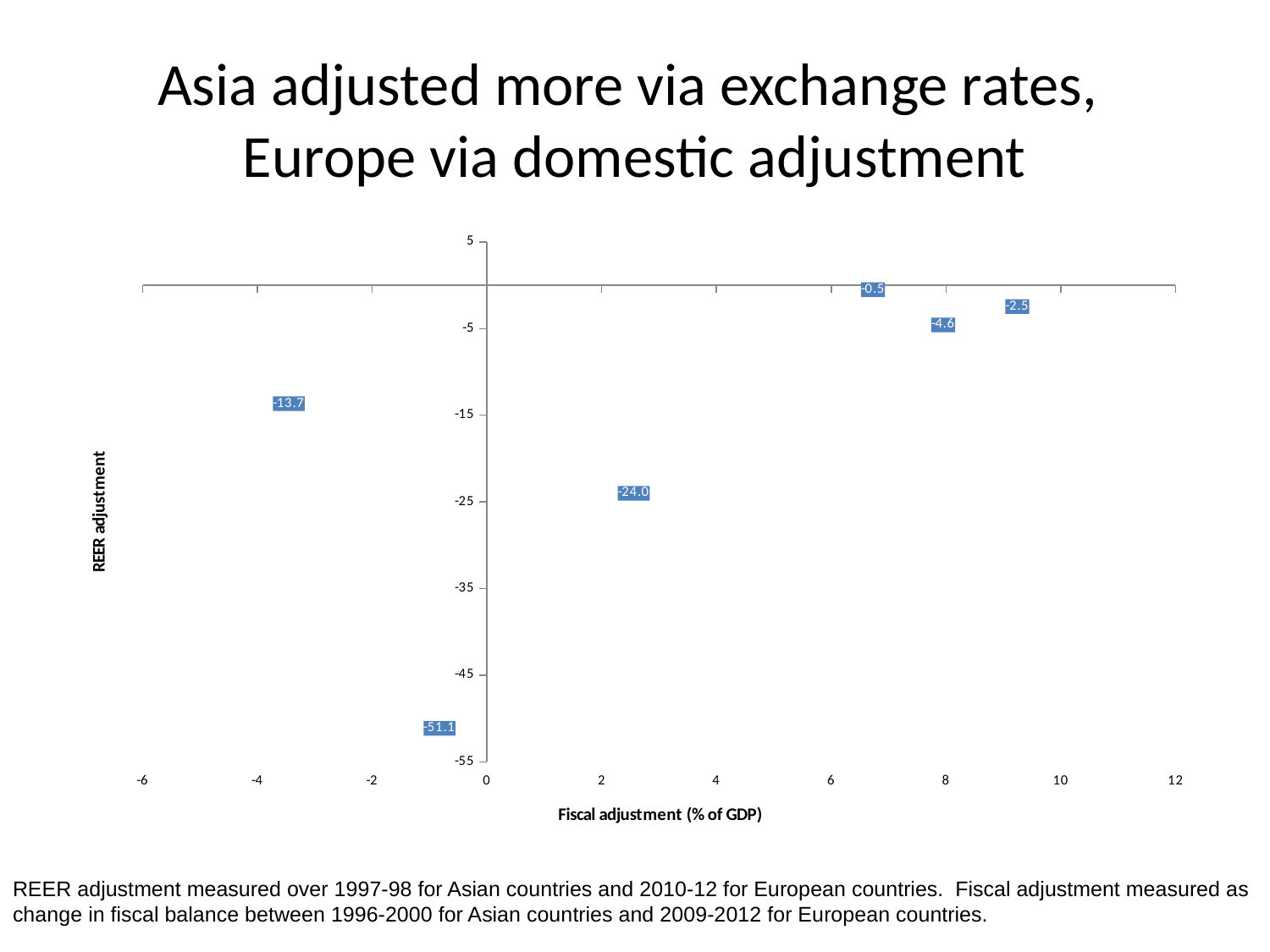
Is the fiscal adjustment for the point labelled -51.1 greater or less than 0? less Is the fiscal adjustment for the point labelled -4.6 greater or less than 6? greater What is the difference between the points labelled -13.7 and -24.0? 10.3 How many data points are plotted on the chart? 6 What is the title of the vertical axis? REER adjustment Is the fiscal adjustment for the point labelled -13.7 greater or less than -2? less What is the lowest REER adjustment value labelled on the chart? -51.1 What is the difference between the highest labelled REER adjustment (-0.5) and the lowest (-51.1)? 50.6 What kind of chart is shown on the slide? scatter chart What is the title of the horizontal axis? Fiscal adjustment (% of GDP) What is the highest REER adjustment value labelled on the chart? -0.5 How many points have a REER adjustment below -15? 2